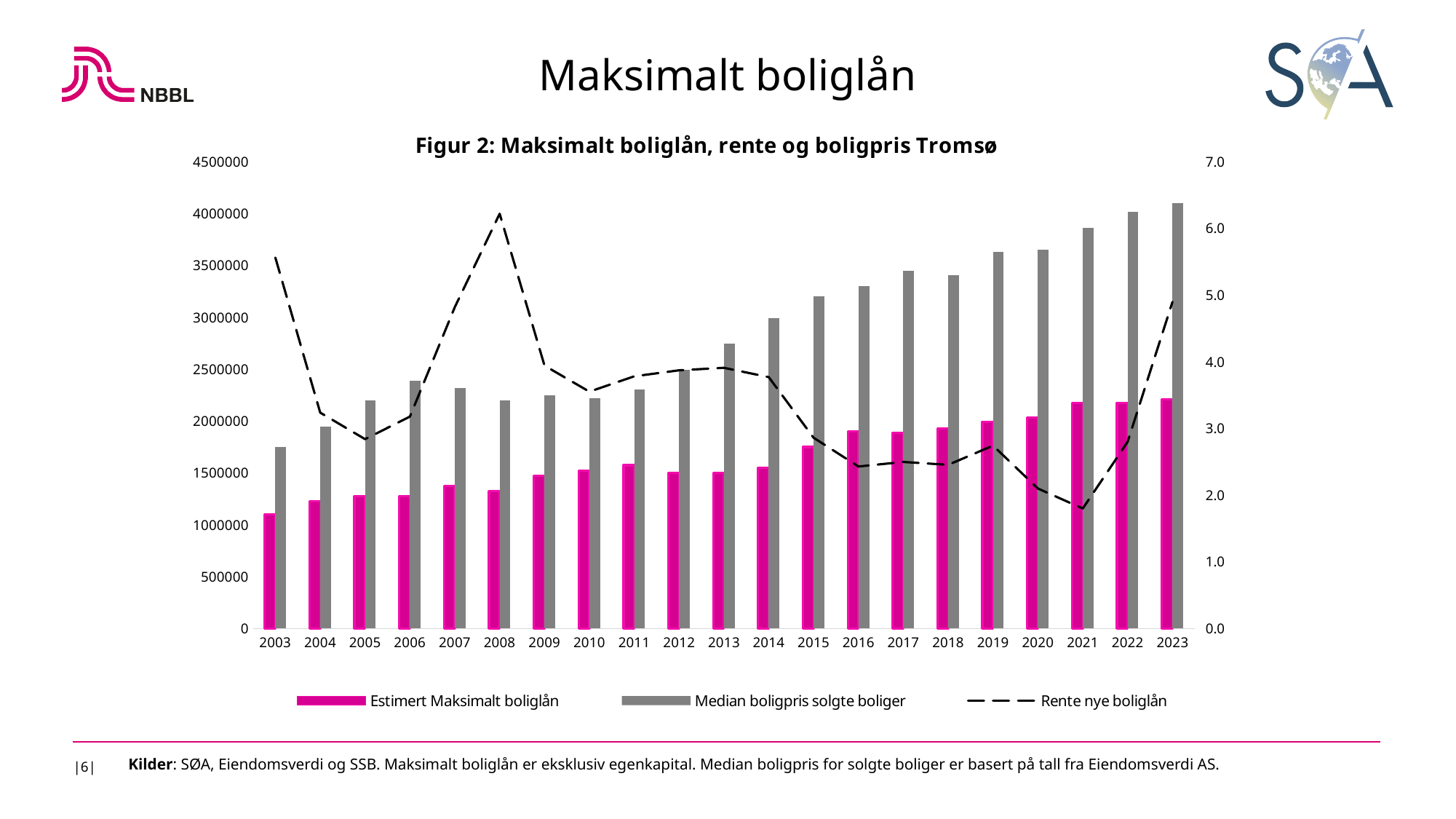
Which series is drawn as a dashed line? Rente nye boliglån What kind of chart is shown on the slide? A combined bar and line chart How many years are shown on the x axis? 21 Is the value for Rente nye boliglån in 2021 greater or less than 2.0? less Which is larger, Median boligpris solgte boliger in 2013 or in 2014? 2014 In which year is Median boligpris solgte boliger highest? 2023 What is the title of the chart? Figur 2: Maksimalt boliglån, rente og boligpris Tromsø In which year is Median boligpris solgte boliger lowest? 2003 How many series does the legend list? 3 Is the value for Median boligpris solgte boliger in 2023 greater or less than 4000000? greater In which year is Estimert Maksimalt boliglån lowest? 2003 Is the value for Median boligpris solgte boliger in 2003 greater or less than 2000000? less